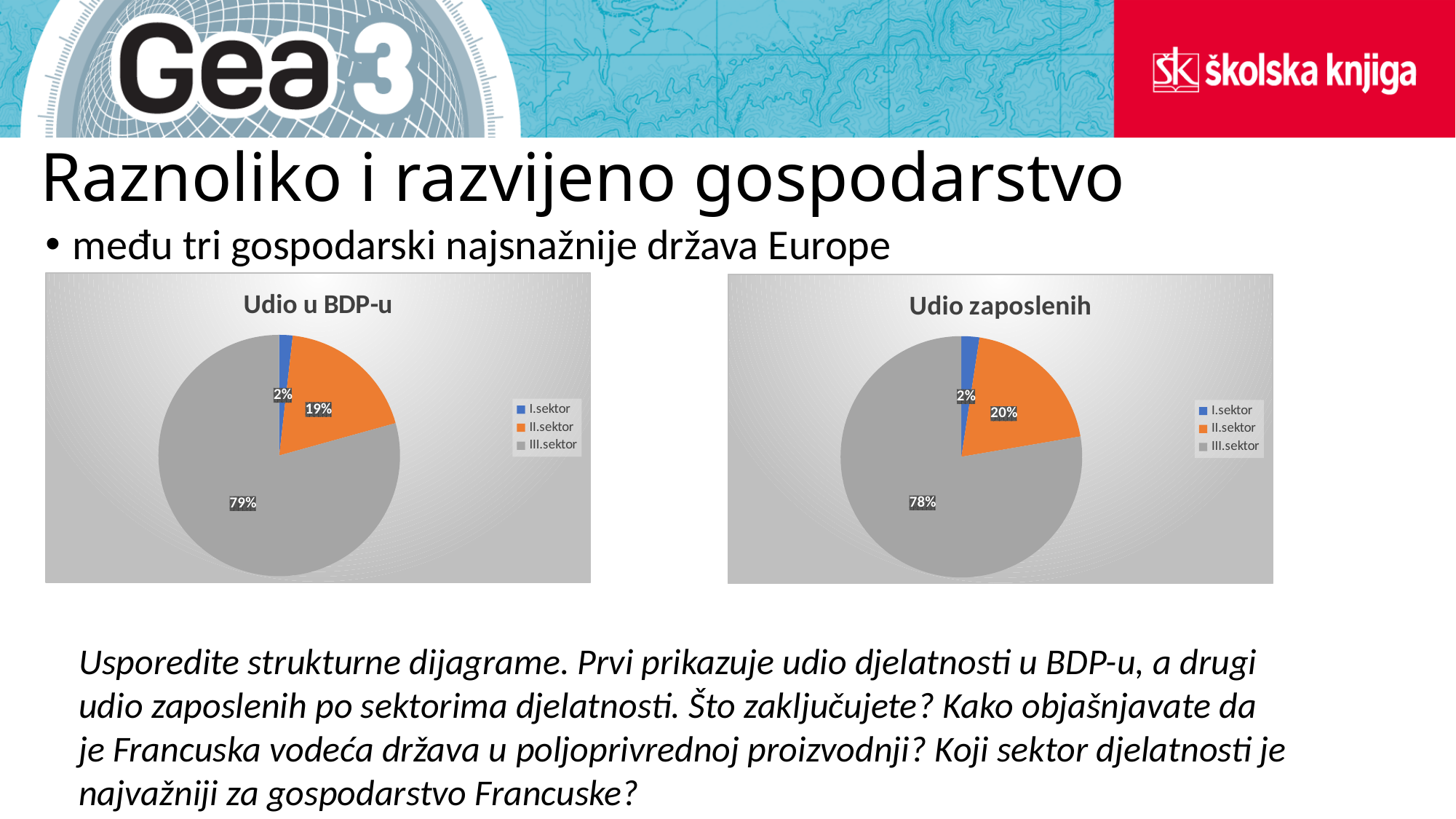
In the 'Udio u BDP-u' chart, what is the difference in percentage points between III.sektor and II.sektor? 60 In the 'Udio zaposlenih' chart, what share does II.sektor have? 20% In the 'Udio zaposlenih' chart, which sector has the smallest share? I.sektor How many slices does the 'Udio zaposlenih' pie chart have? 3 In the 'Udio u BDP-u' chart, what share does III.sektor have? 79% In the 'Udio zaposlenih' chart, what share does III.sektor have? 78% In the 'Udio u BDP-u' chart, which sector has the largest share? III.sektor What type of chart is the 'Udio u BDP-u' chart? pie chart In the 'Udio zaposlenih' chart, what share does I.sektor have? 2% In the 'Udio u BDP-u' chart, what share does II.sektor have? 19% Which colour represents II.sektor in the 'Udio u BDP-u' chart? orange In the 'Udio zaposlenih' chart, is the share of II.sektor larger or smaller than the share of I.sektor? larger